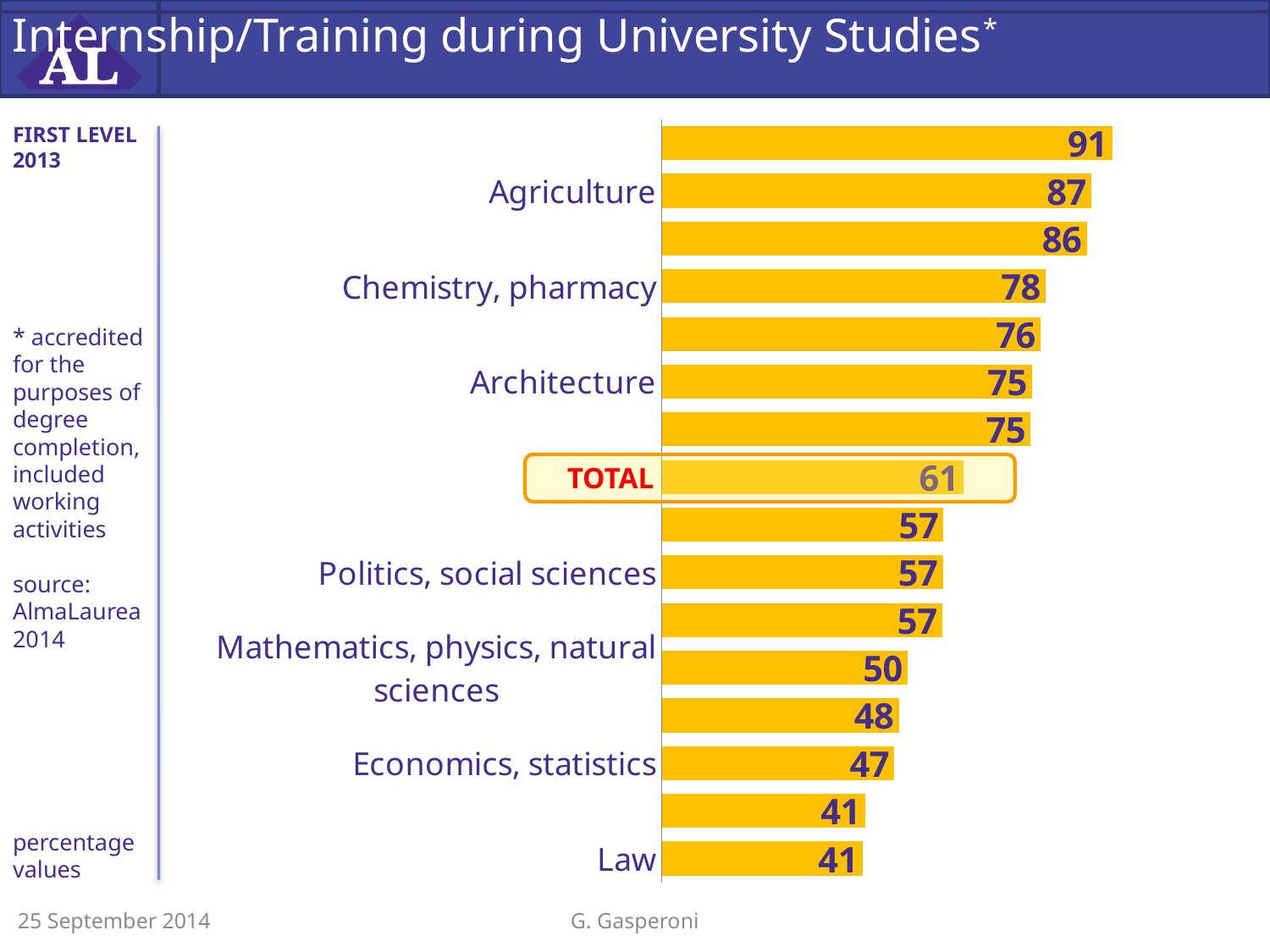
What is the value for Chemistry, pharmacy? 78 What is the value for Architecture? 75 Which is larger, the value for Architecture or the value for Politics, social sciences? Architecture What is the value for TOTAL? 61 What is the value for Economics, statistics? 47 What is the value for Agriculture? 87 What is the value for Law? 41 What is the difference between the values for Agriculture and Law? 46 What is the title of the slide? Internship/Training during University Studies* What is the highest value shown on the chart? 91 What is the value for Politics, social sciences? 57 What kind of chart is shown on the slide? bar chart